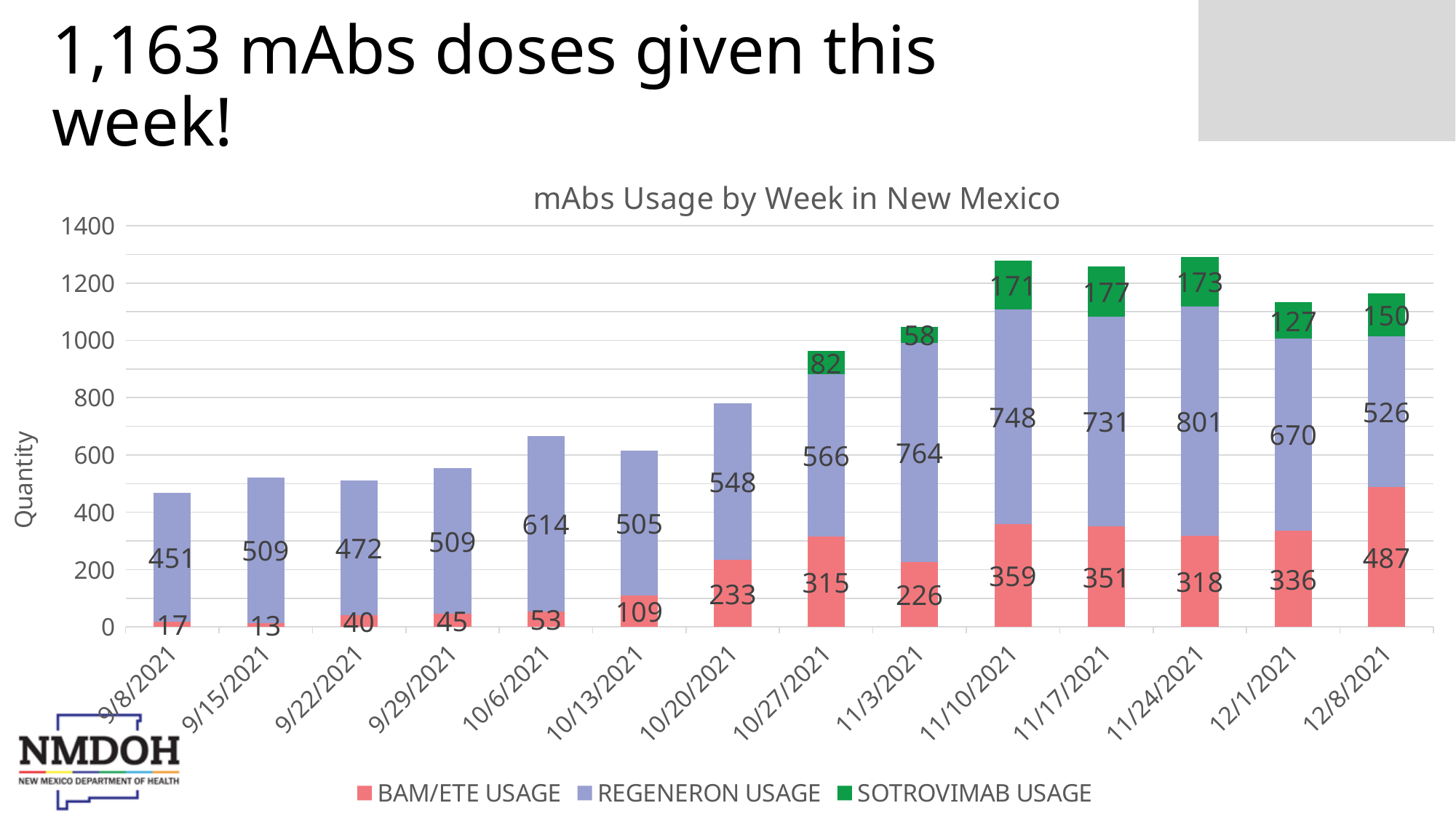
What is the REGENERON USAGE value for the week of 11/24/2021? 801 What is the SOTROVIMAB USAGE value for the week of 10/27/2021? 82 Which is larger: SOTROVIMAB USAGE on 11/17/2021 or on 12/1/2021? 11/17/2021 Which week has the lowest BAM/ETE USAGE? 9/15/2021 What type of chart is shown on the slide? Stacked bar chart What is the difference between BAM/ETE USAGE on 12/8/2021 and on 12/1/2021? 151 How many weeks are shown on the x axis? 14 What is the total of the stacked bar for 12/8/2021? 1,163 What is the title of the chart? mAbs Usage by Week in New Mexico How many series does the legend list? 3 Which week has the highest REGENERON USAGE? 11/24/2021 What is the BAM/ETE USAGE value for the week of 12/8/2021? 487